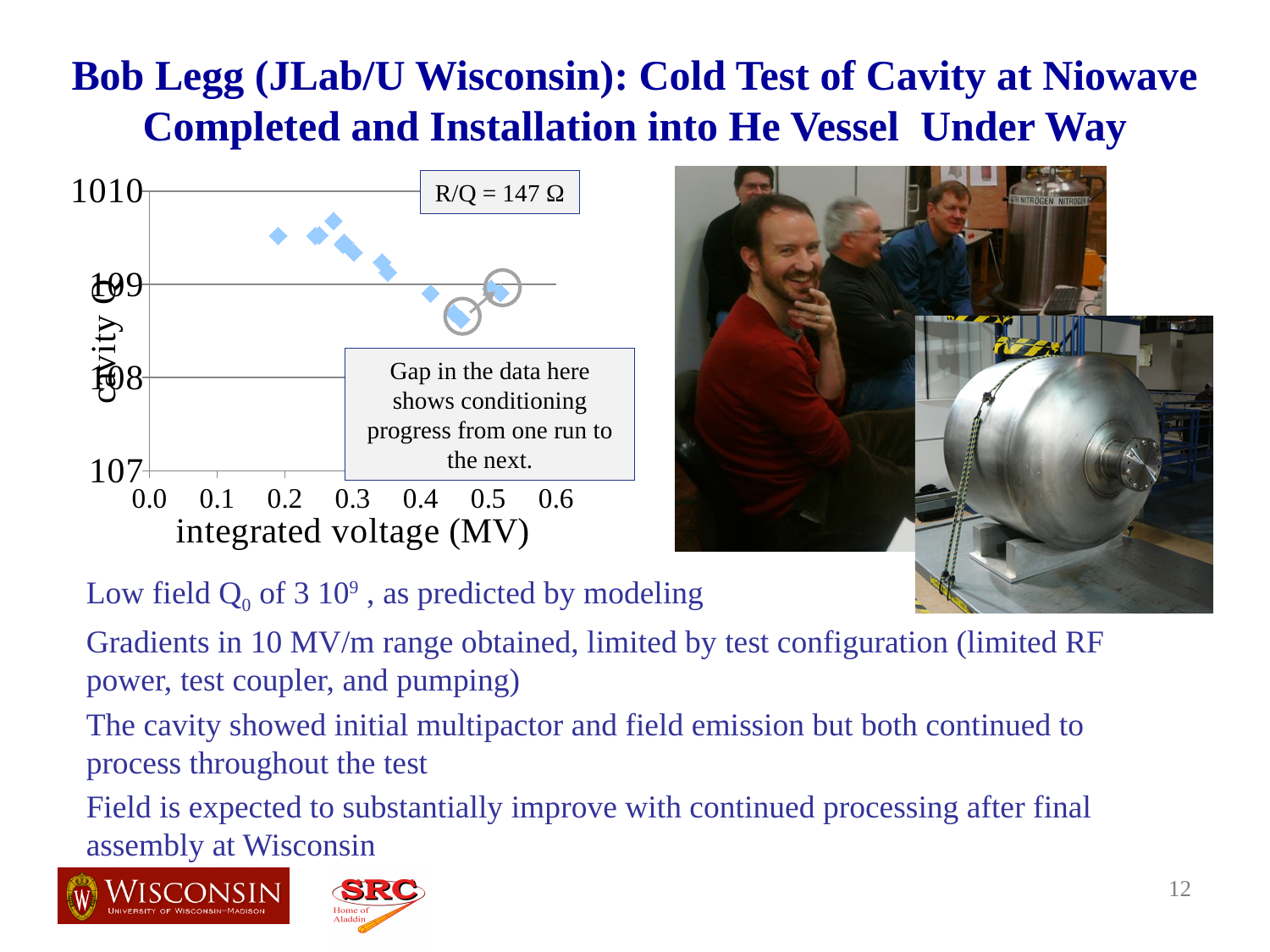
What kind of chart is shown on the left of the slide? scatter chart Are all plotted cavity Q values greater or less than 10^10? less What is the label of the y axis of the chart? cavity Q As integrated voltage increases along the x axis, does cavity Q rise or fall? fall What R/Q value is annotated on the chart? R/Q = 147 Ω Are all plotted cavity Q values greater or less than 10^8? greater Is the cavity Q at an integrated voltage of about 0.45 MV greater or less than 10^9? less Is the cavity Q higher at an integrated voltage of about 0.2 MV or at about 0.5 MV? about 0.2 MV What is the maximum value shown on the x axis of the chart? 0.6 What is the label of the x axis of the chart? integrated voltage (MV)